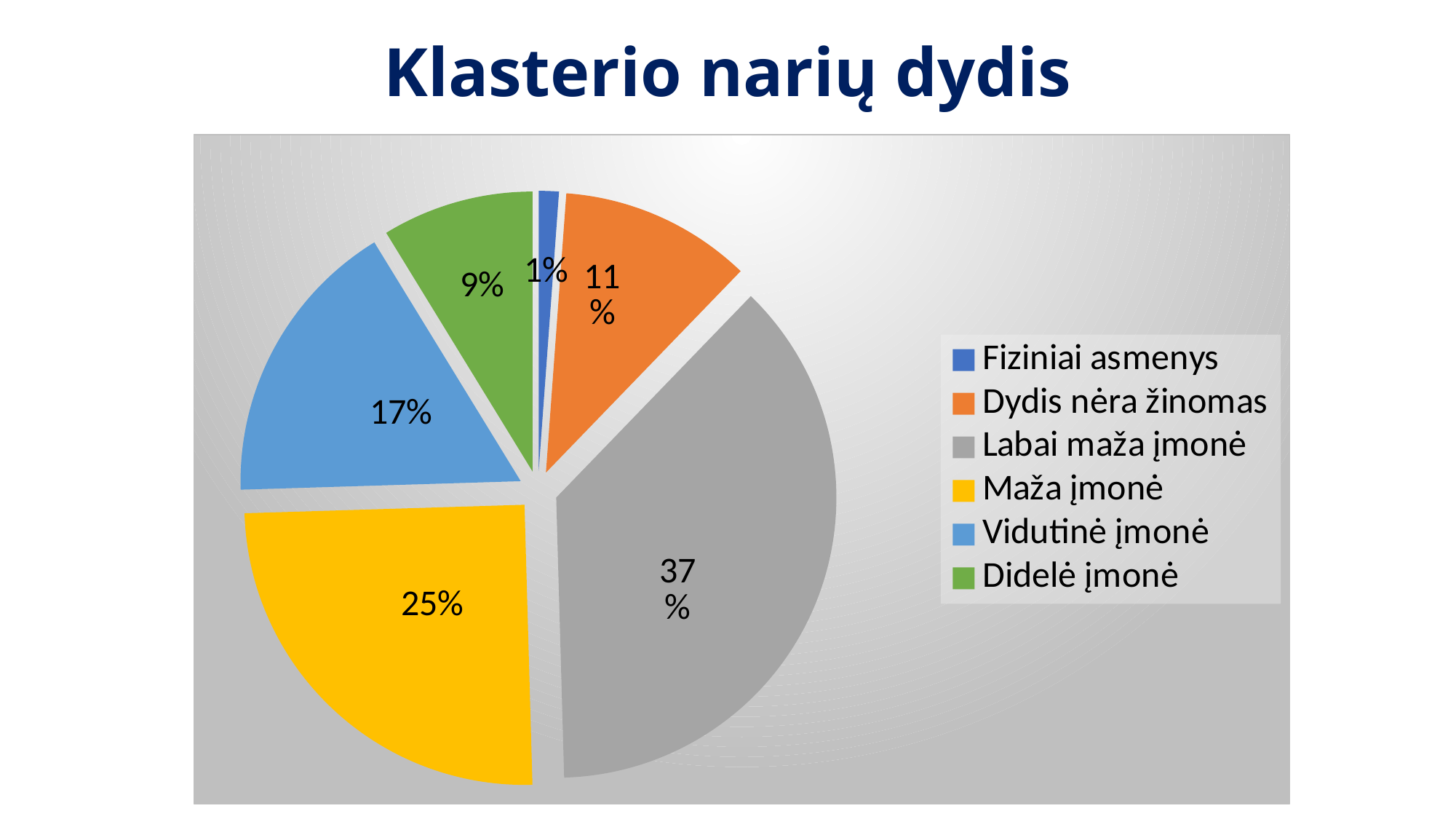
Which is larger, the slice for Vidutinė įmonė or the slice for Didelė įmonė? Vidutinė įmonė What share of the pie does Fiziniai asmenys have? 1% What share of the pie does Labai maža įmonė have? 37% How many categories does the pie chart have? 6 Which category has the largest slice of the pie? Labai maža įmonė Which category has the smallest slice of the pie? Fiziniai asmenys What is the difference in percentage points between Labai maža įmonė and Maža įmonė? 12 What is the title of the chart? Klasterio narių dydis What share of the pie does Maža įmonė have? 25% What kind of chart is shown on the slide? pie chart What share of the pie does Dydis nėra žinomas have? 11% What share of the pie does Vidutinė įmonė have? 17%